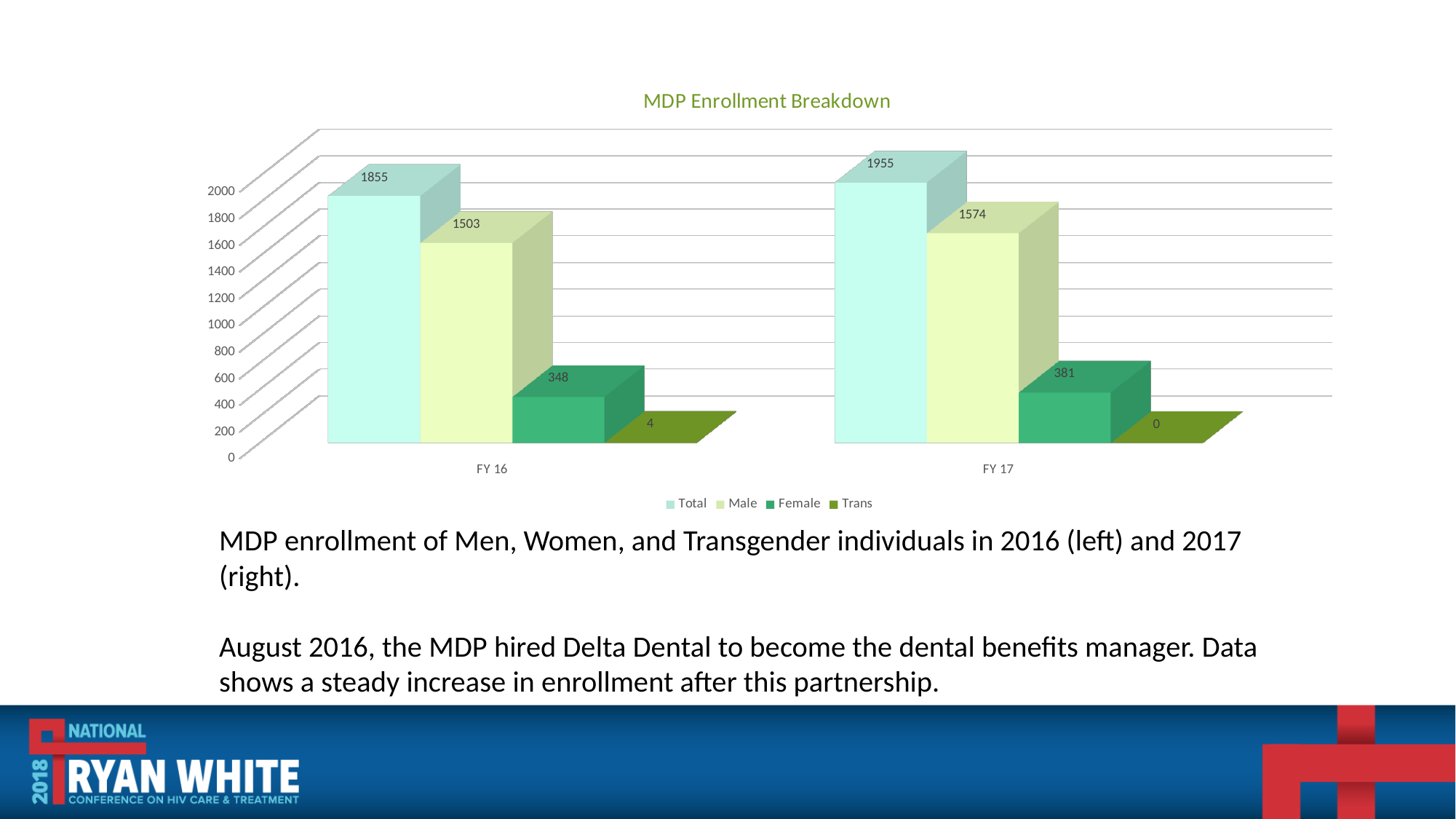
What is the title of the chart? MDP Enrollment Breakdown How many series does the legend list? 4 What is the difference between the Female enrollment in FY 17 and FY 16? 33 Which series has the lowest value in FY 16? Trans What is the Trans enrollment value for FY 17? 0 Which fiscal year has the higher Total enrollment? FY 17 What is the Male enrollment value for FY 17? 1574 What is the Female enrollment value for FY 16? 348 What is the Total enrollment value for FY 16? 1855 What is the difference between the Total enrollment in FY 17 and FY 16? 100 What kind of chart is shown on the slide? Bar chart How many fiscal year categories are shown on the x axis? 2